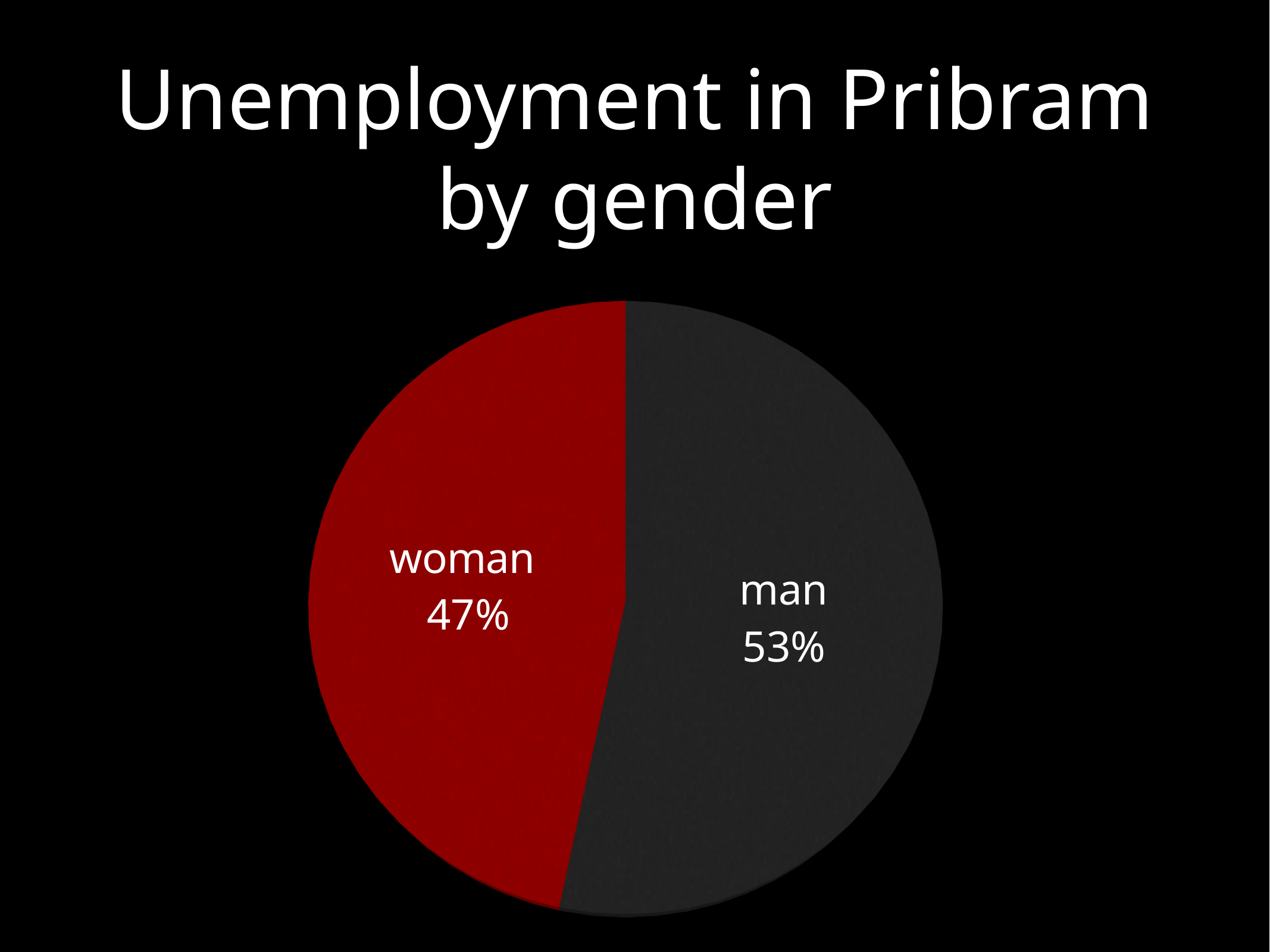
What share of the pie does the woman slice represent? 47% Is the value for man greater or less than 50%? greater Is the value for woman greater or less than 50%? less What is the difference in percentage points between the man and woman slices? 6 Which slice is the largest? man What is the title of the chart? Unemployment in Pribram by gender How many slices does the pie chart have? 2 Which slice is the smallest? woman What colour is the woman slice? red What share of the pie does the man slice represent? 53% Which is larger, the man slice or the woman slice? man What kind of chart is shown on the slide? pie chart